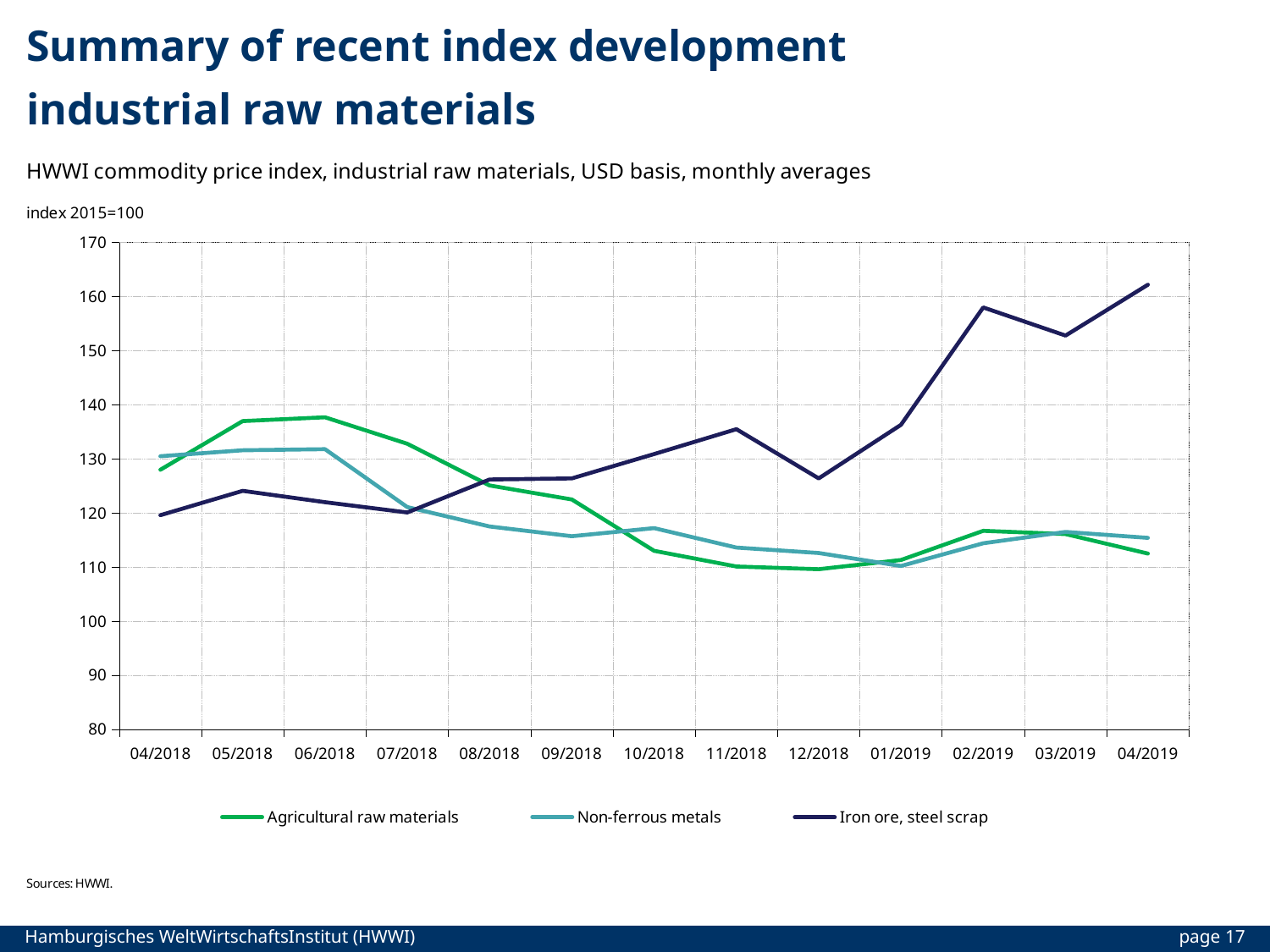
Is the value for Agricultural raw materials in 12/2018 greater or less than 120? less In which month does the Iron ore, steel scrap series reach its highest value? 04/2019 In 04/2019, which series has the higher value: Iron ore, steel scrap or Agricultural raw materials? Iron ore, steel scrap What is the base year of the index according to the axis label? 2015=100 Does the Iron ore, steel scrap series rise or fall from 12/2018 to 04/2019? rise Does the Agricultural raw materials series rise or fall from 06/2018 to 12/2018? fall How many months are plotted along the x axis? 13 In 04/2018, which series has the higher value: Non-ferrous metals or Iron ore, steel scrap? Non-ferrous metals How many series does the legend list? 3 Is the value for Iron ore, steel scrap in 04/2019 greater or less than 150? greater Is the value for Non-ferrous metals in 06/2018 greater or less than 130? greater What kind of chart is shown on the slide? line chart